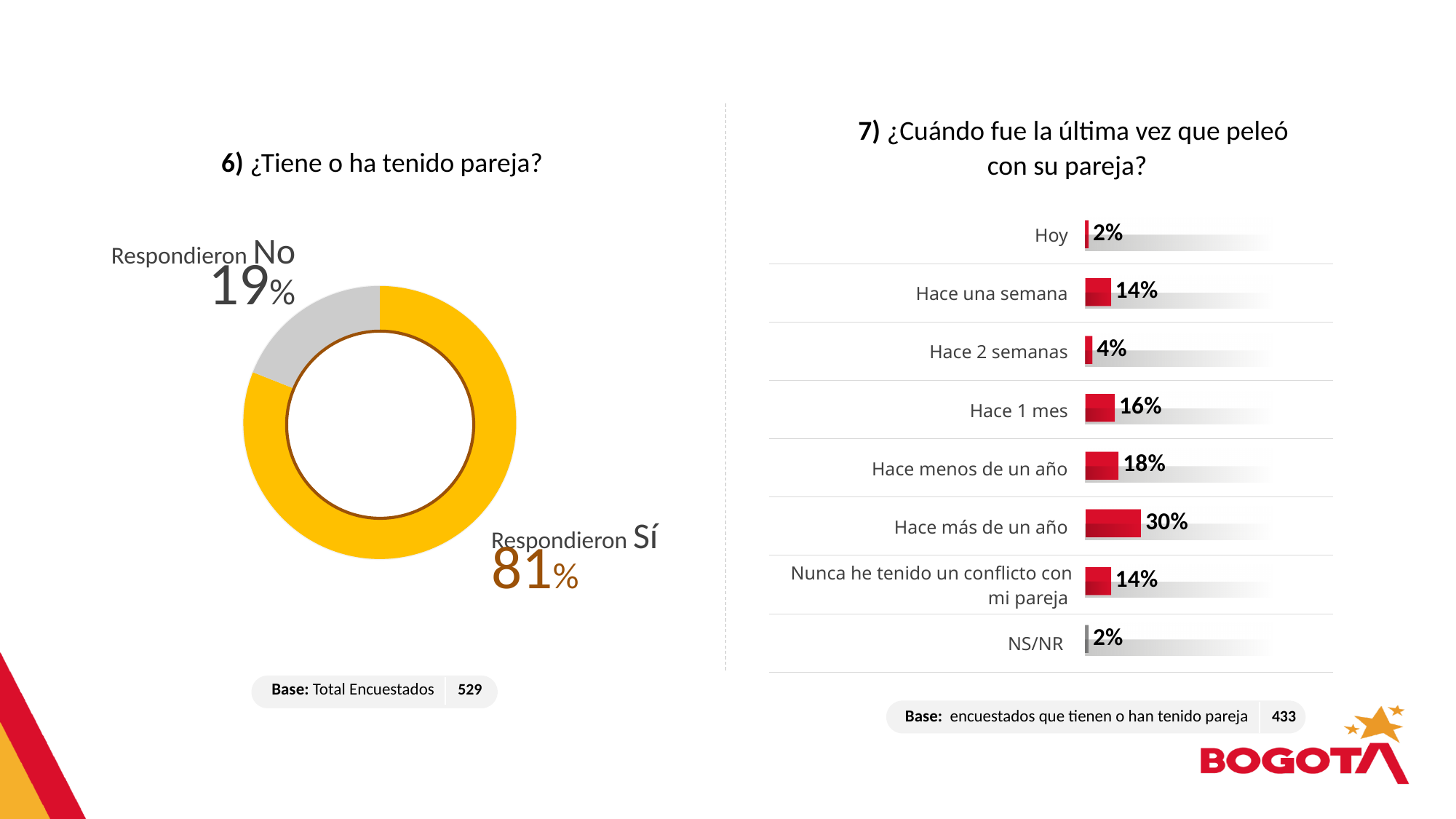
What kind of chart is used for '¿Cuándo fue la última vez que peleó con su pareja?'? Bar chart In the chart '¿Cuándo fue la última vez que peleó con su pareja?', which category has the highest value? Hace más de un año In the chart '¿Cuándo fue la última vez que peleó con su pareja?', which is larger: 'Hace una semana' or 'Hace 2 semanas'? Hace una semana In the chart '¿Cuándo fue la última vez que peleó con su pareja?', what is the value for 'Nunca he tenido un conflicto con mi pareja'? 14% In the chart '¿Cuándo fue la última vez que peleó con su pareja?', what is the value for 'Hace más de un año'? 30% In the chart '¿Cuándo fue la última vez que peleó con su pareja?', what is the value for 'Hace 1 mes'? 16% In the chart '¿Cuándo fue la última vez que peleó con su pareja?', how many categories are shown? 8 What kind of chart is used for '¿Tiene o ha tenido pareja?'? Doughnut chart In the chart '¿Cuándo fue la última vez que peleó con su pareja?', what is the difference between 'Hace más de un año' and 'Hace menos de un año'? 12% In the chart '¿Tiene o ha tenido pareja?', what percentage of respondents answered Sí? 81% In the chart '¿Tiene o ha tenido pareja?', what is the difference between the Sí and No percentages? 62% In the chart '¿Tiene o ha tenido pareja?', what percentage of respondents answered No? 19%